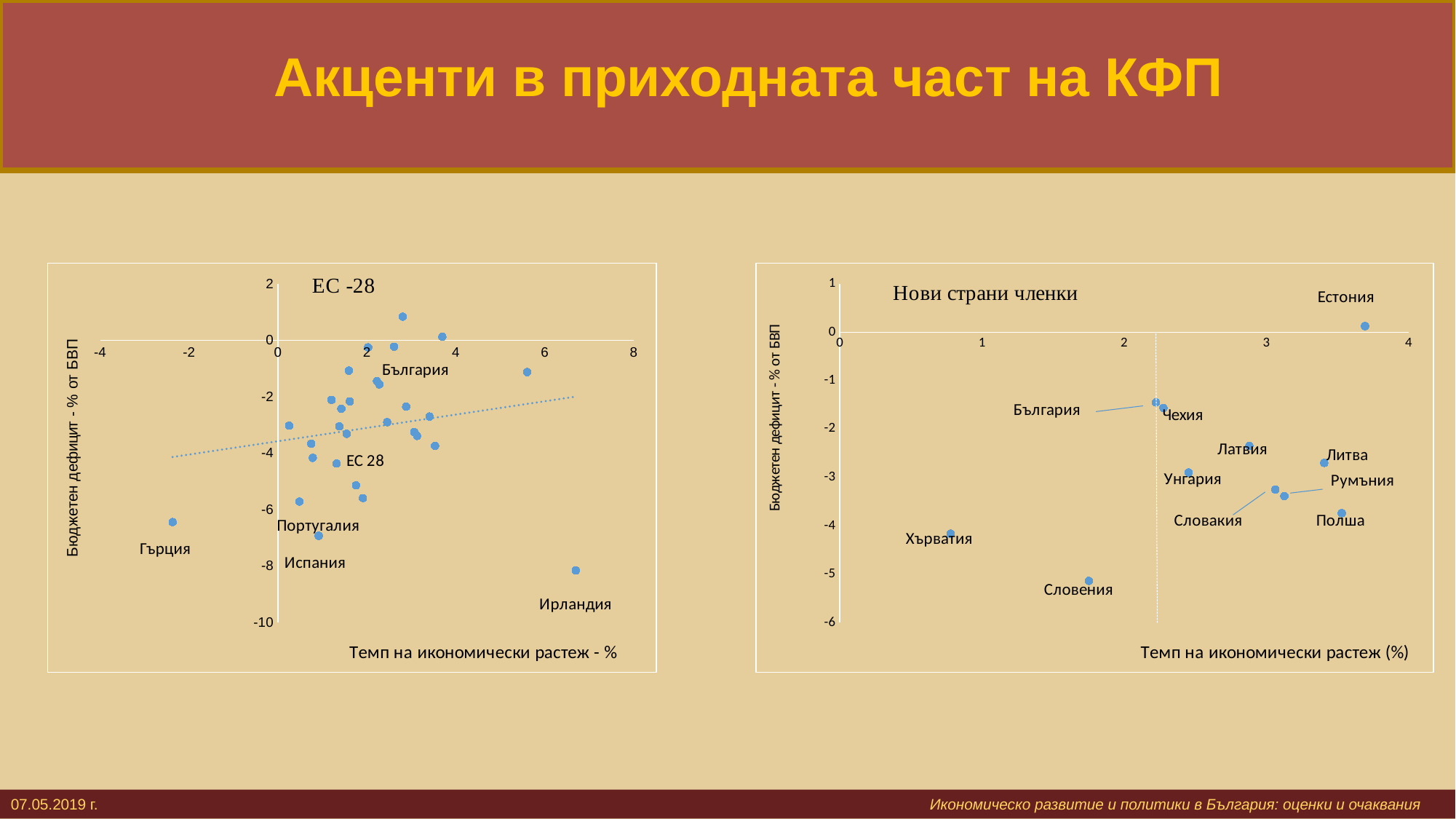
In the right chart 'Нови страни членки', is the economic growth rate for Хърватия greater or less than 1? less In the left chart 'ЕС -28', does the dotted trend line rise or fall from left to right? rise In the right chart 'Нови страни членки', which has the higher budget deficit value, Естония or Словения? Естония In the right chart 'Нови страни членки', which country has the highest economic growth rate? Естония In the right chart 'Нови страни членки', which country has the lowest budget deficit value? Словения In the left chart 'ЕС -28', is the economic growth rate for Ирландия greater or less than 6? greater In the right chart 'Нови страни членки', is the economic growth rate for Естония greater or less than 3? greater What kind of chart is the left chart titled 'ЕС -28'? scatter chart In the left chart 'ЕС -28', which labelled country has the lowest economic growth rate? Гърция What is the title of the right chart? Нови страни членки In the left chart 'ЕС -28', which labelled country has the lowest budget deficit value? Ирландия What is the x-axis label of the right chart 'Нови страни членки'? Темп на икономически растеж (%)